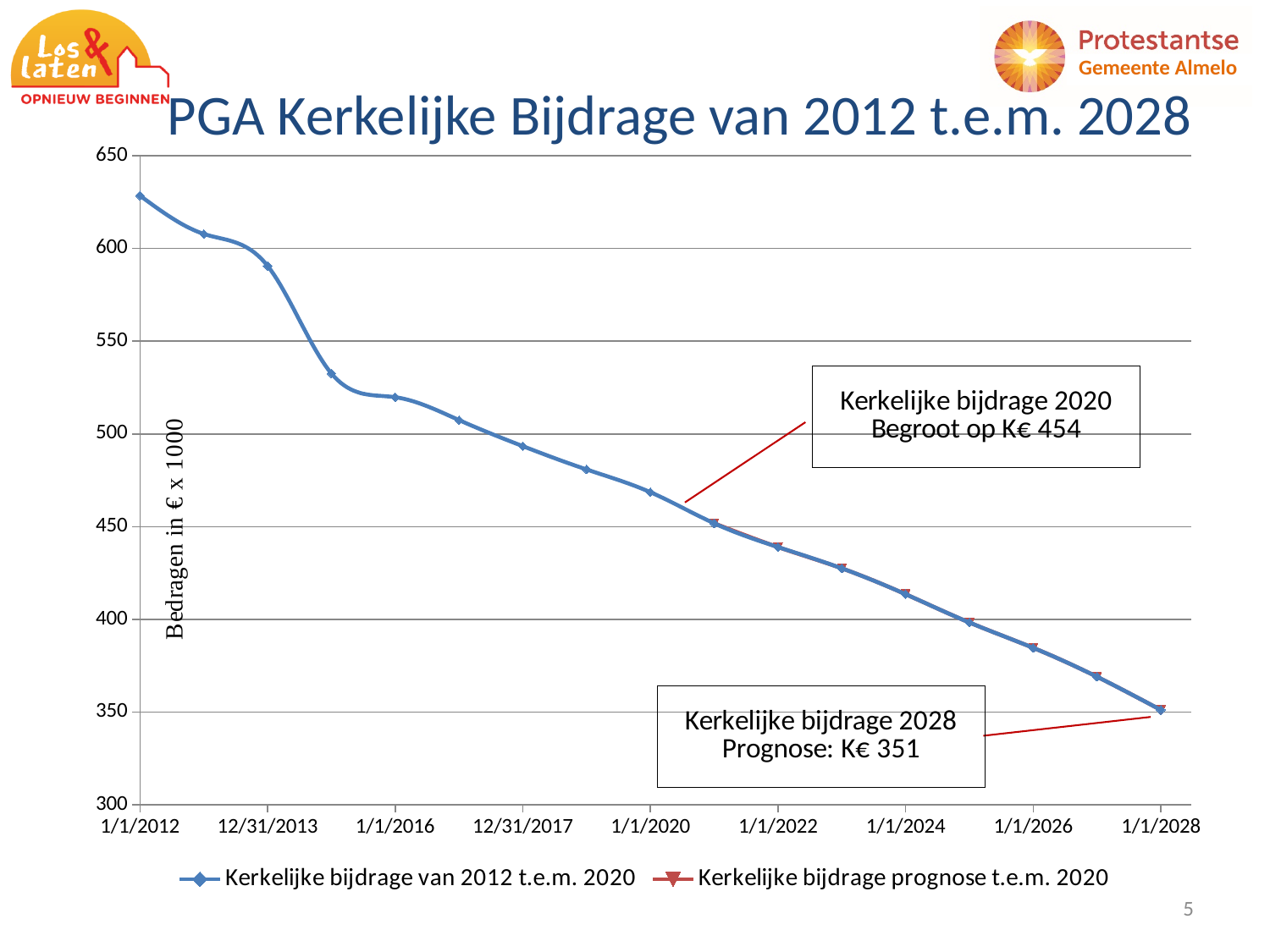
What is the label on the vertical axis? Bedragen in € x 1000 According to the annotation, what is the forecast Kerkelijke bijdrage for 2028? K€ 351 Is the value at 1/1/2016 greater or less than 500? greater According to the annotation, what is the budgeted Kerkelijke bijdrage for 2020? K€ 454 Is the value at 1/1/2012 greater or less than 600? greater What kind of chart is shown on the slide? line chart How many series does the legend list? 2 Do the values rise or fall from 1/1/2012 to 1/1/2028? fall Which is larger, the Kerkelijke bijdrage for 2020 or the forecast for 2028? 2020 Is the value at 1/1/2026 greater or less than 400? less What is the title of the chart? PGA Kerkelijke Bijdrage van 2012 t.e.m. 2028 What is the difference between the 2020 budgeted value (K€ 454) and the 2028 forecast (K€ 351)? K€ 103